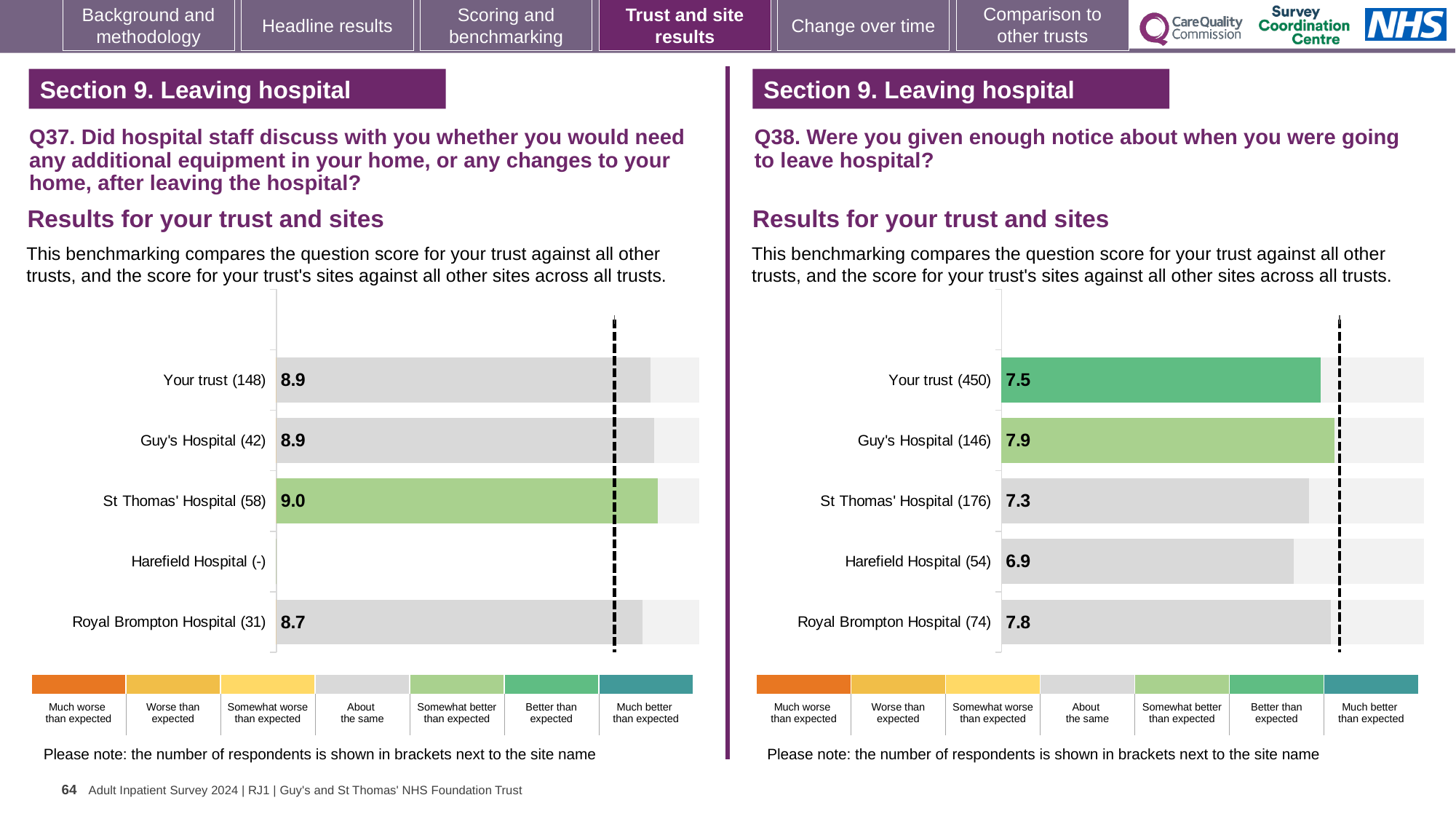
In the Q37 chart on the left, what is the score for St Thomas' Hospital (58)? 9.0 In the Q38 chart on the right, which has the higher score, Royal Brompton Hospital or Your trust? Royal Brompton Hospital In the Q38 chart on the right, which site has the lowest score? Harefield Hospital (54) What kind of chart is used for the Q38 results on the right? Bar chart In the Q37 chart on the left, which site has no score shown? Harefield Hospital (-) In the Q37 chart on the left, what is the score for Your trust (148)? 8.9 In the Q38 chart on the right, what is the score for Harefield Hospital (54)? 6.9 In the Q38 chart on the right, what is the score for Your trust (450)? 7.5 In the Q38 chart on the right, which site has the highest score? Guy's Hospital (146) In the Q37 chart on the left, which site has the lowest score? Royal Brompton Hospital (31) In the Q37 chart on the left, what is the difference between the scores for St Thomas' Hospital and Royal Brompton Hospital? 0.3 In the Q38 chart on the right, what is the difference between the scores for Guy's Hospital and St Thomas' Hospital? 0.6